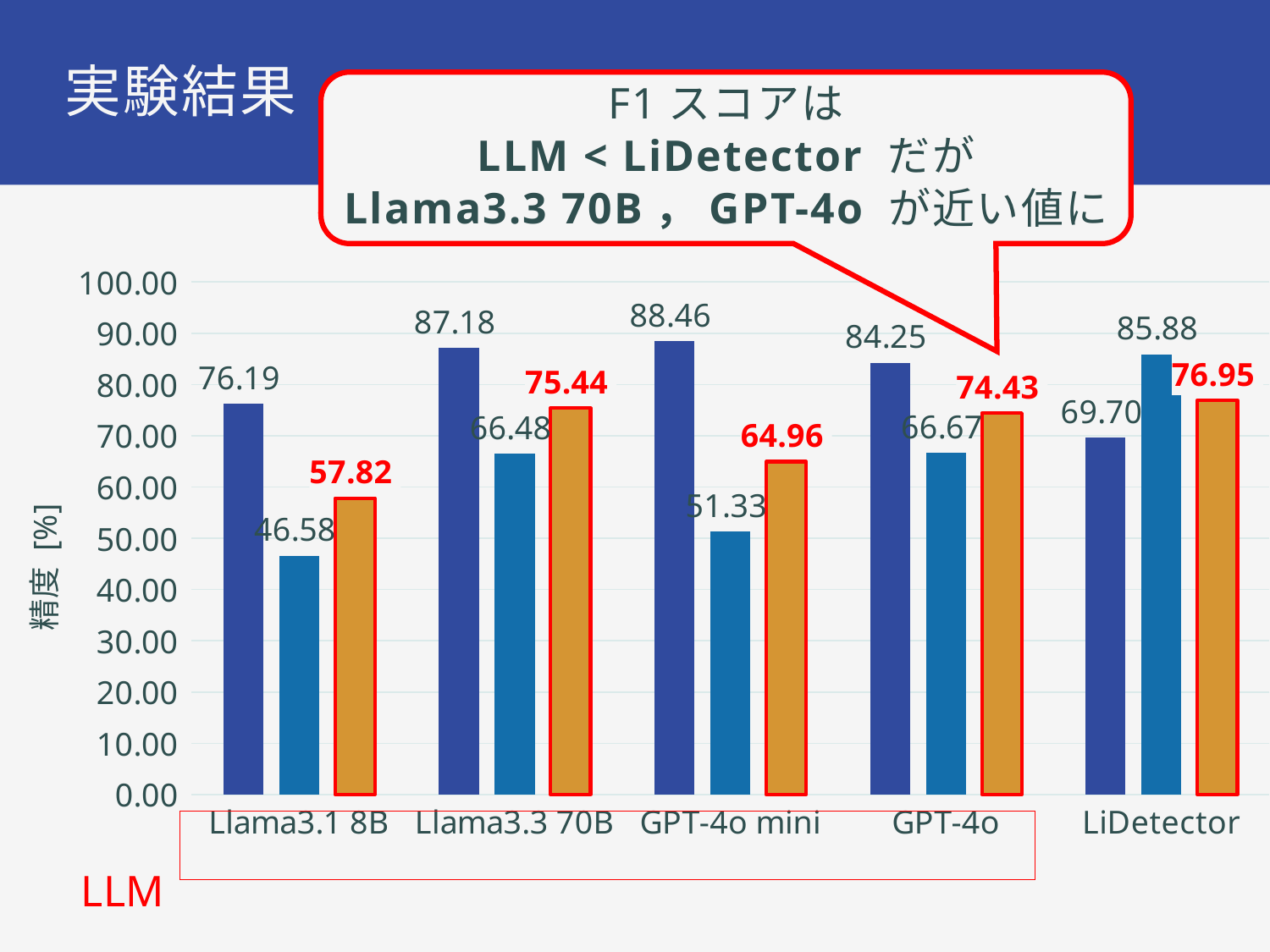
What is the value of the light blue bar for LiDetector? 85.88 Which category has the highest dark blue bar? GPT-4o mini What is the difference between the orange bar values for LiDetector and GPT-4o? 2.52 What is the value of the orange (F1 score) bar for Llama3.3 70B? 75.44 Which category has the highest orange (F1 score) bar? LiDetector Which is larger: the dark blue bar for Llama3.3 70B or the dark blue bar for GPT-4o mini? GPT-4o mini What is the value of the light blue bar for Llama3.1 8B? 46.58 What is the value of the dark blue bar for GPT-4o mini? 88.46 How many categories are shown on the x axis? 5 What is the difference between the dark blue and light blue bar values for Llama3.1 8B? 29.61 What kind of chart is shown on the slide? Bar chart Which category has the lowest orange (F1 score) bar? Llama3.1 8B